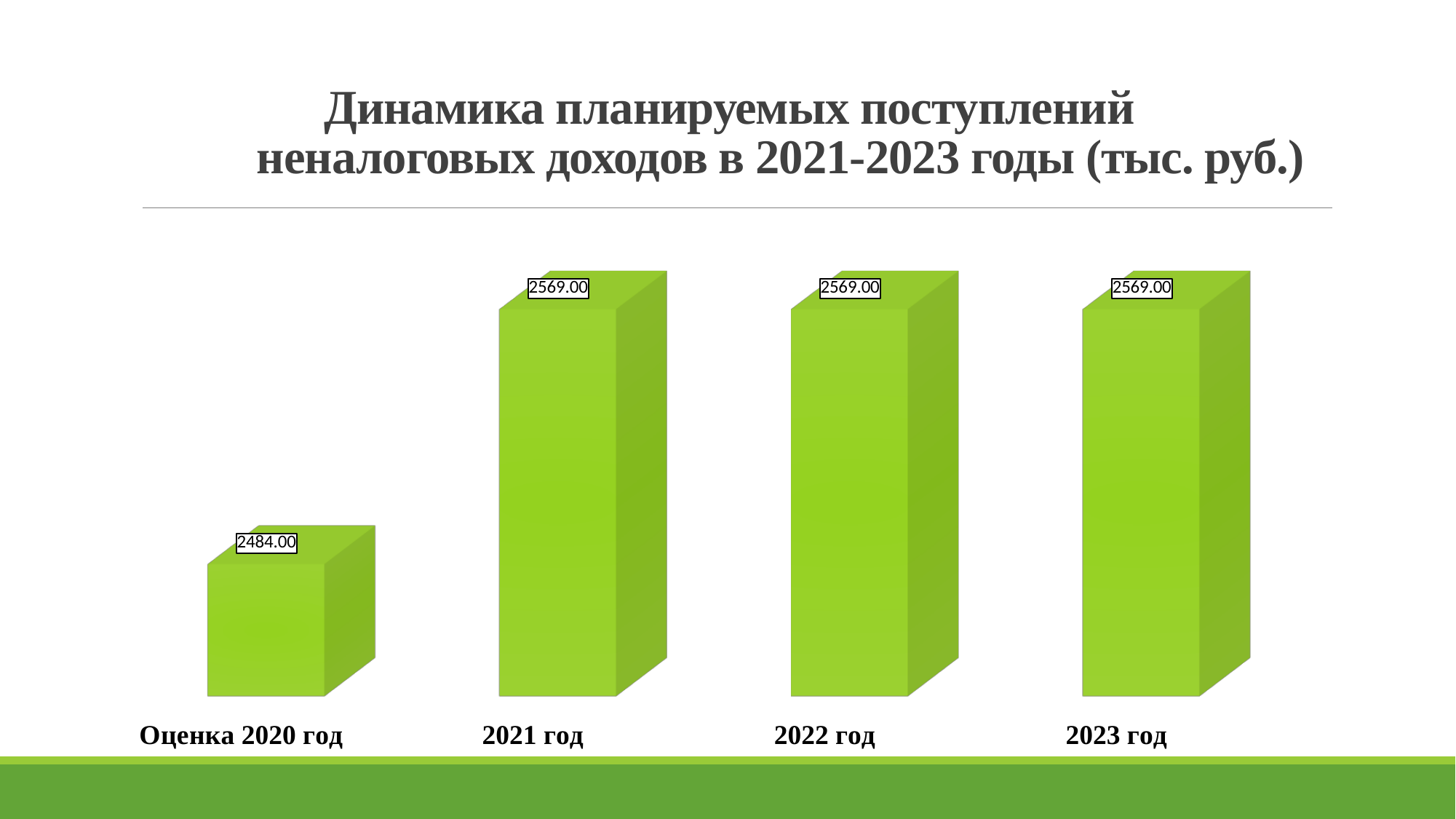
What is the value for 2023 год? 2569.00 How many categories are shown on the chart? 4 What kind of chart is shown on the slide? bar chart Which category has the lowest value? Оценка 2020 год What is the value for Оценка 2020 год? 2484.00 What is the difference between the values for 2021 год and Оценка 2020 год? 85.00 Are the values for 2021 год, 2022 год and 2023 год the same or different? the same What colour are the bars on the chart? green What is the title of the chart? Динамика планируемых поступлений неналоговых доходов в 2021-2023 годы (тыс. руб.) What is the value for 2021 год? 2569.00 Do the values rise or fall from Оценка 2020 год to 2021 год? rise Which is larger, the value for Оценка 2020 год or the value for 2022 год? 2022 год